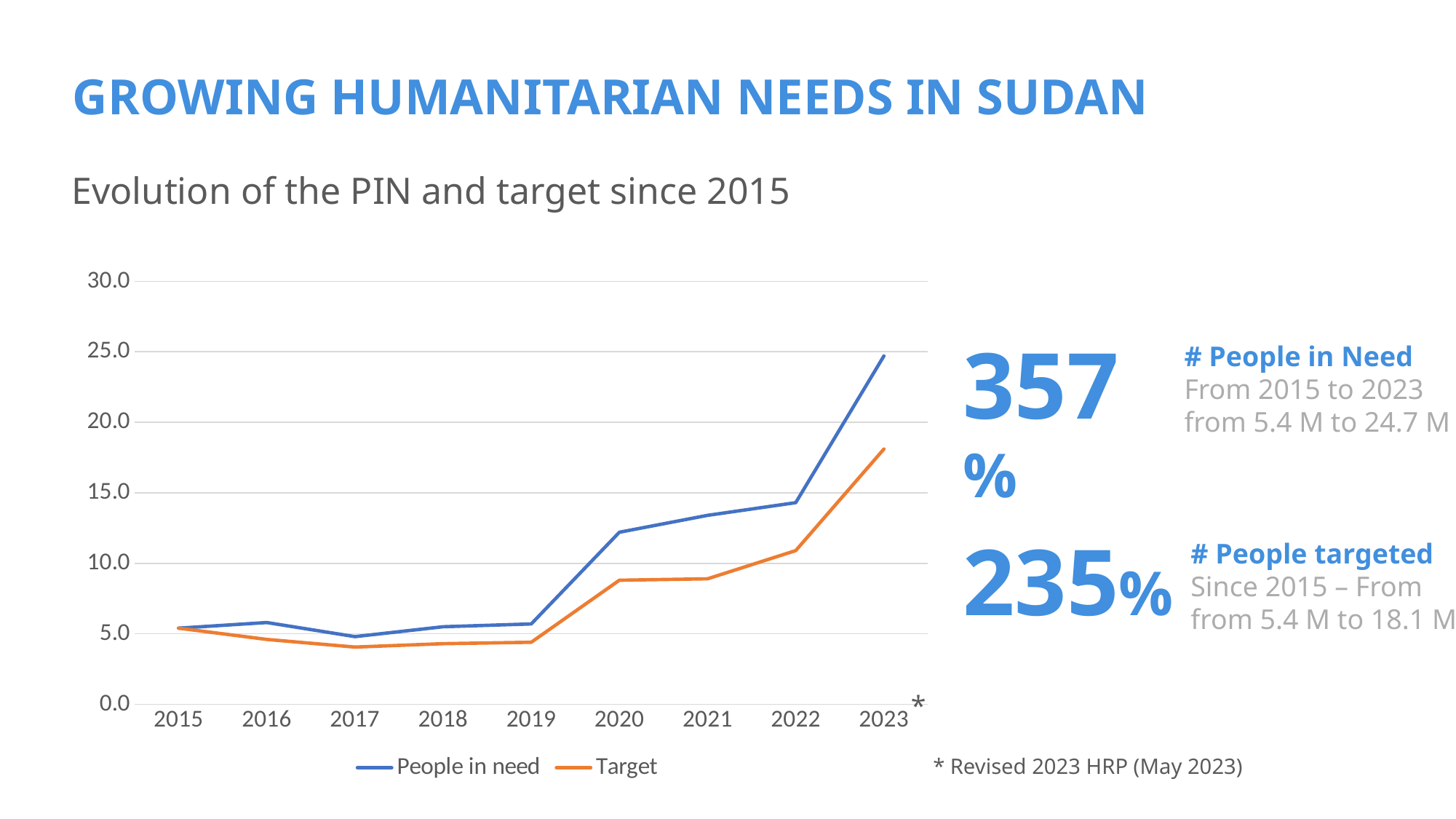
How many series does the chart legend list? 2 Which series is drawn in orange on the chart? Target In which year does the People in need line reach its highest value? 2023 What kind of chart is shown on the slide? Line chart Is the People in need value for 2021 greater or less than 15.0? less Is the People in need value for 2020 greater or less than 10.0? greater How many years are plotted along the x axis of the chart? 9 In which year is the Target line at its lowest value? 2017 Overall, do the People in need values rise or fall from 2015 to 2023? Rise In 2020, which series has the larger value, People in need or Target? People in need Is the Target value for 2023 greater or less than 15.0? greater